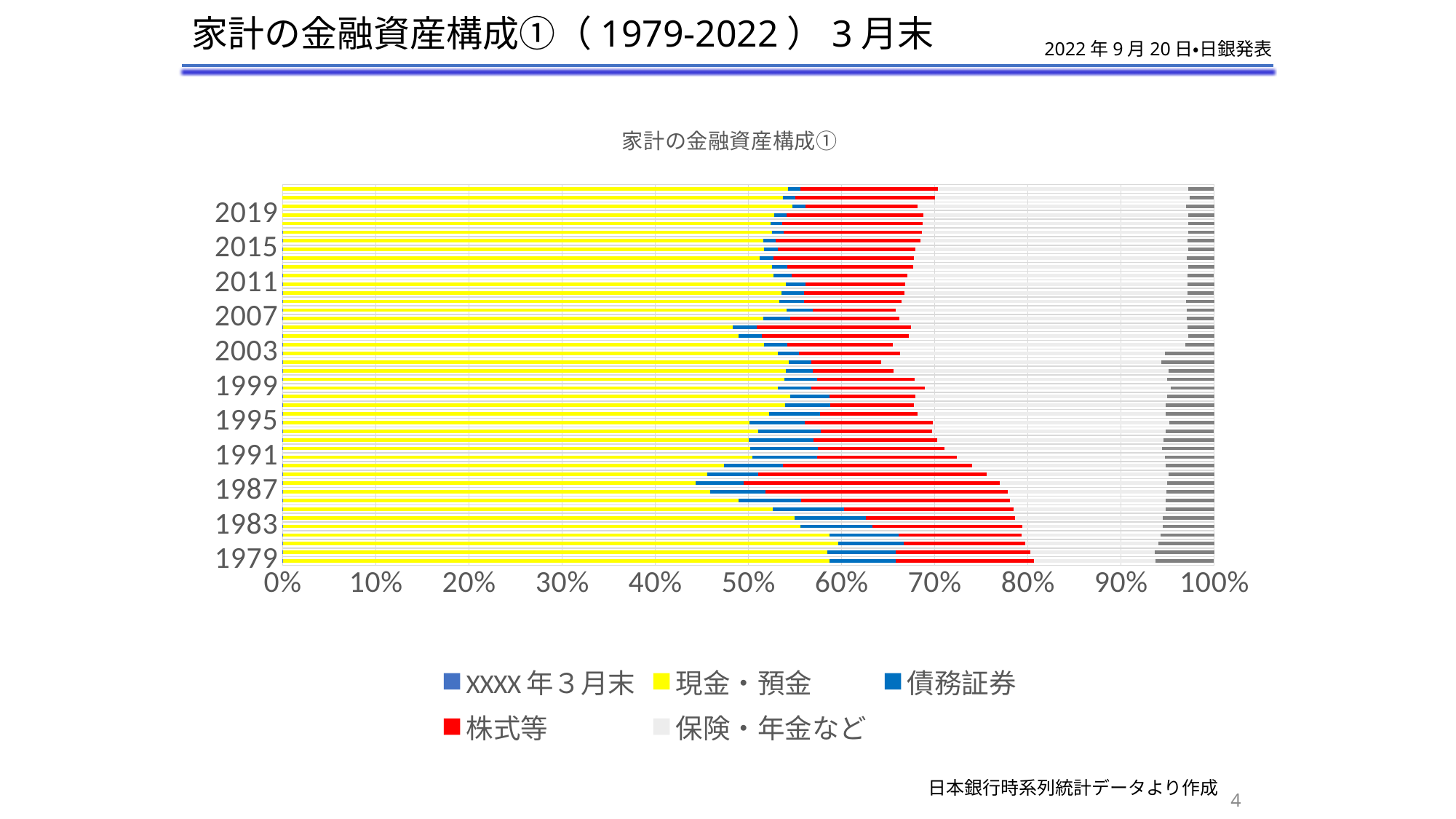
Is the 現金・預金 share for 1987 greater or less than 50%? less Which year has the larger 現金・預金 share, 1979 or 1987? 1979 What kind of chart is shown on the slide? Stacked horizontal bar chart What is the title of the chart? 家計の金融資産構成① How many years (bars) are plotted in the chart, covering 1979 to 2022? 44 Is the 現金・預金 share for 1979 greater or less than 70%? less Is the 現金・預金 share for 1979 greater or less than 50%? greater Which year has the larger 株式等 share, 1987 or 2011? 1987 Which colour represents 株式等 in the chart? Red What is the highest value shown on the horizontal axis? 100% How many series does the legend list? 5